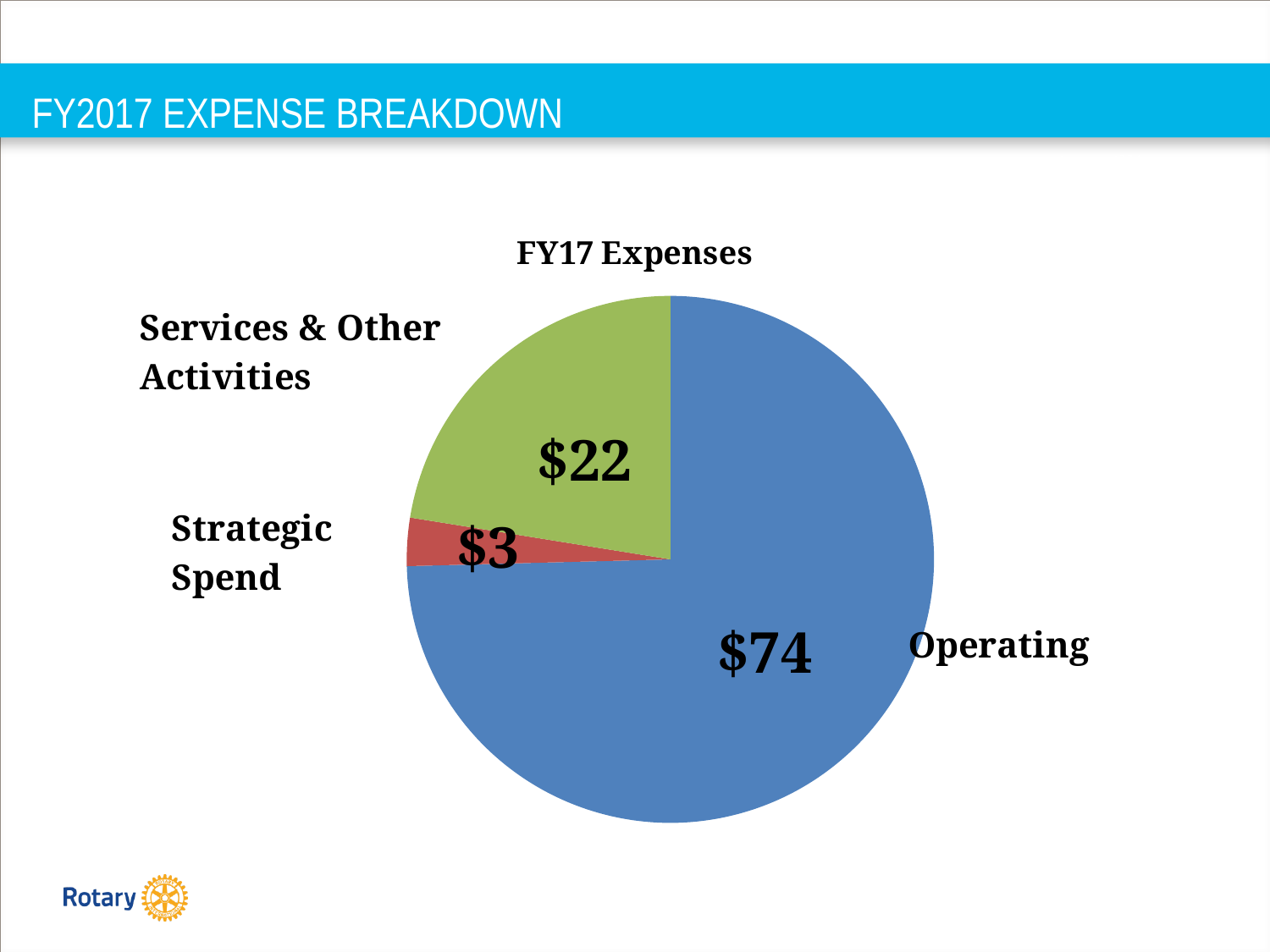
What type of chart is shown on the slide? pie chart What colour is the Operating slice? blue What is the value of the Strategic Spend slice? $3 What is the title of the chart? FY17 Expenses Which category has the smallest slice of the pie? Strategic Spend What is the difference between the Operating value and the Services & Other Activities value? $52 What is the difference between the Services & Other Activities value and the Strategic Spend value? $19 What is the value of the Operating slice? $74 Which is larger, Services & Other Activities or Strategic Spend? Services & Other Activities Which category has the largest slice of the pie? Operating What is the value of the Services & Other Activities slice? $22 How many slices does the pie chart have? 3